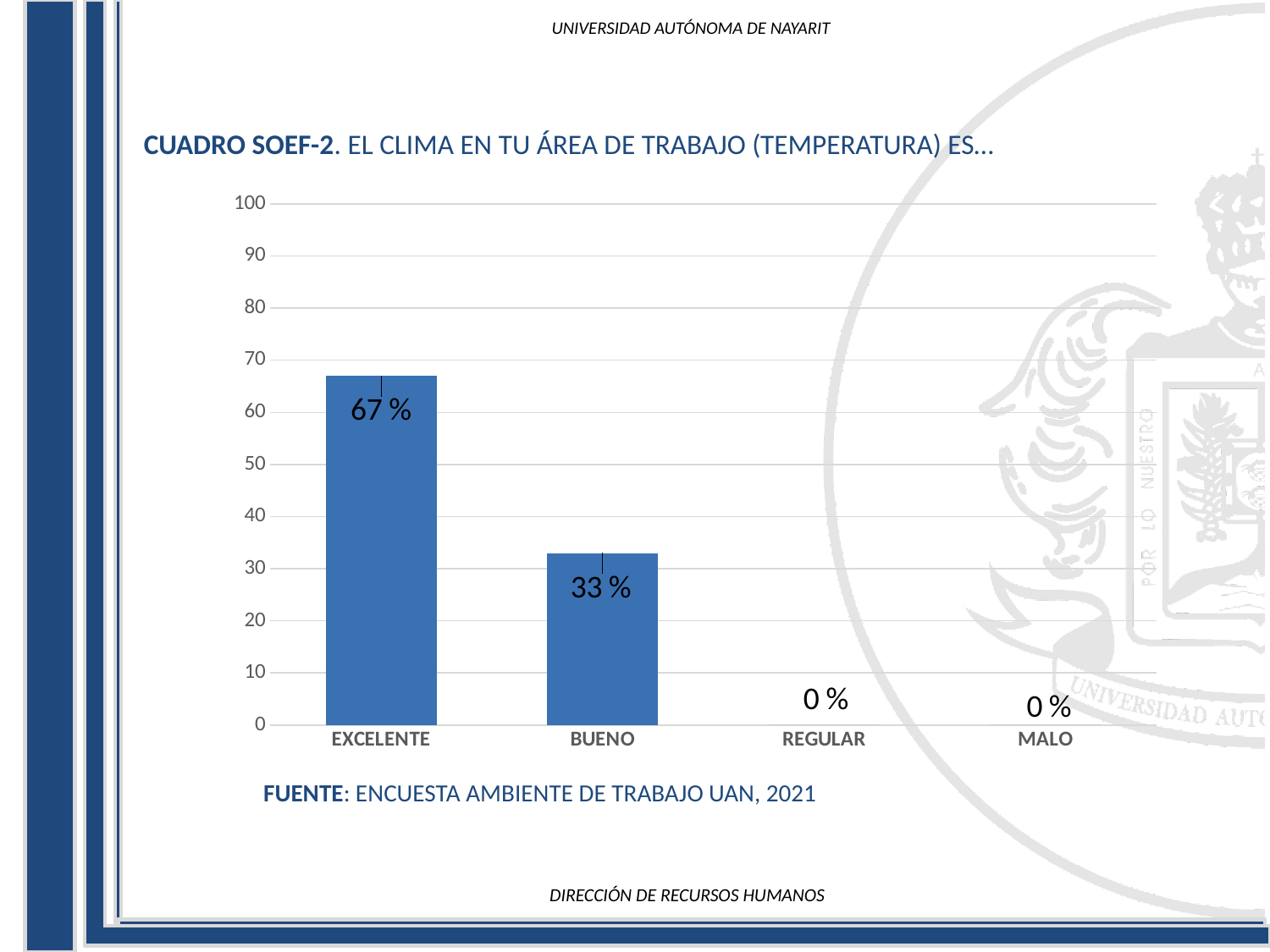
Is the value for BUENO greater or less than 40? less What is the value for REGULAR? 0 % Which is larger, the value for EXCELENTE or the value for BUENO? EXCELENTE What is the source cited below the chart? ENCUESTA AMBIENTE DE TRABAJO UAN, 2021 How many categories are shown on the x axis? 4 What is the value for BUENO? 33 % What kind of chart is shown on the slide? bar chart Is the value for EXCELENTE greater or less than 60? greater What is the value for EXCELENTE? 67 % What is the difference between the values for EXCELENTE and BUENO? 34 % What is the value for MALO? 0 % Which category has the highest value? EXCELENTE